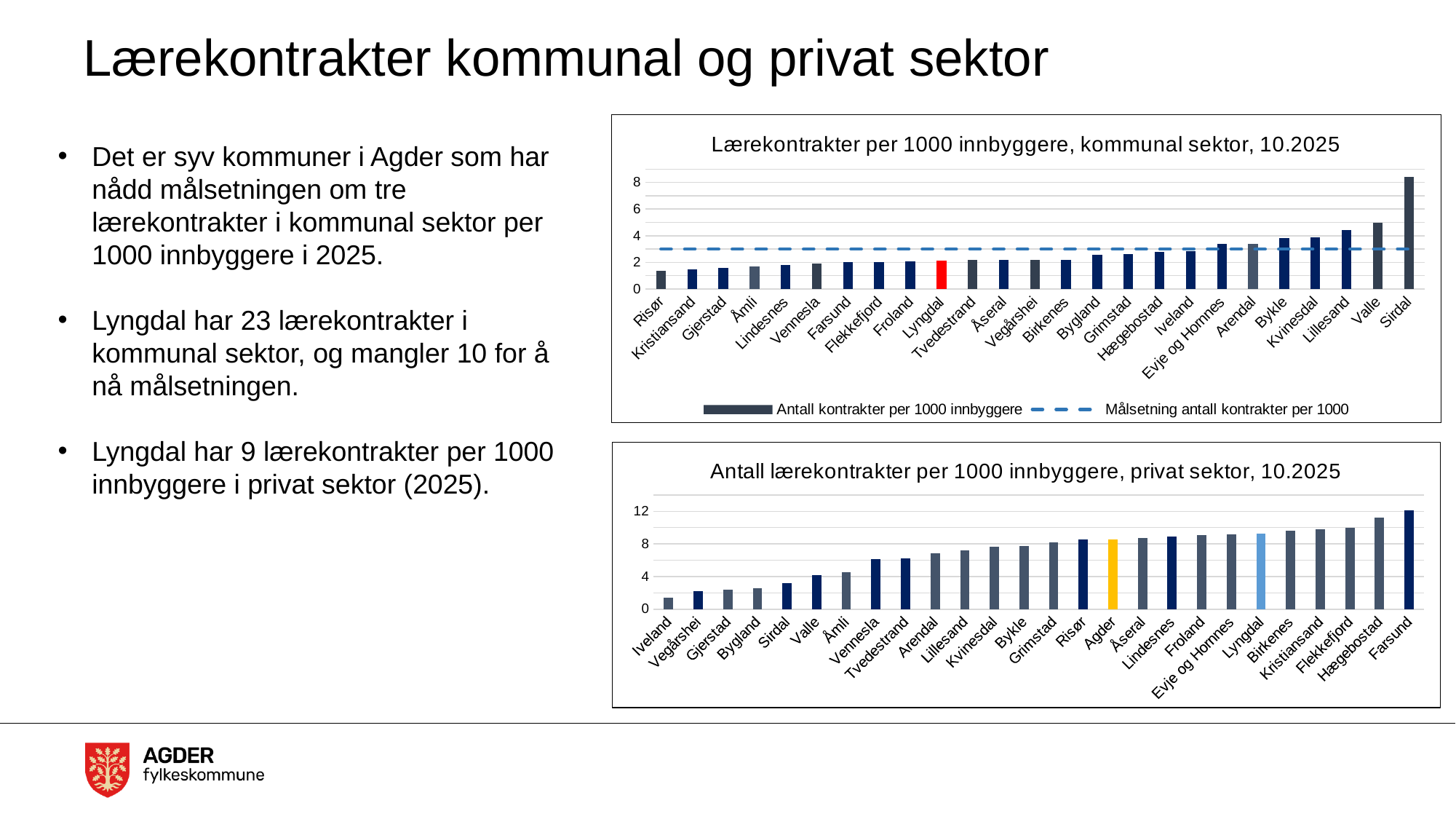
In the chart 'Antall lærekontrakter per 1000 innbyggere, privat sektor, 10.2025', do the values rise or fall from left to right along the x axis? rise In the chart 'Lærekontrakter per 1000 innbyggere, kommunal sektor, 10.2025', how many municipalities are shown on the x axis? 25 In the chart 'Antall lærekontrakter per 1000 innbyggere, privat sektor, 10.2025', which municipality has the lowest value? Iveland In the chart 'Lærekontrakter per 1000 innbyggere, kommunal sektor, 10.2025', which municipality has the highest value? Sirdal In the chart 'Lærekontrakter per 1000 innbyggere, kommunal sektor, 10.2025', is the value for Sirdal greater or less than 8? greater In the chart 'Antall lærekontrakter per 1000 innbyggere, privat sektor, 10.2025', is the value for Hægebostad greater or less than 8? greater In the chart 'Lærekontrakter per 1000 innbyggere, kommunal sektor, 10.2025', how many entries does the legend list? 2 In the chart 'Lærekontrakter per 1000 innbyggere, kommunal sektor, 10.2025', which is larger, the value for Valle or the value for Sirdal? Sirdal In the chart 'Antall lærekontrakter per 1000 innbyggere, privat sektor, 10.2025', which municipality has the highest value? Farsund What kind of chart is 'Antall lærekontrakter per 1000 innbyggere, privat sektor, 10.2025'? bar chart In the chart 'Lærekontrakter per 1000 innbyggere, kommunal sektor, 10.2025', is the value for Risør greater or less than 2? less In the chart 'Lærekontrakter per 1000 innbyggere, kommunal sektor, 10.2025', which municipality has the lowest value? Risør